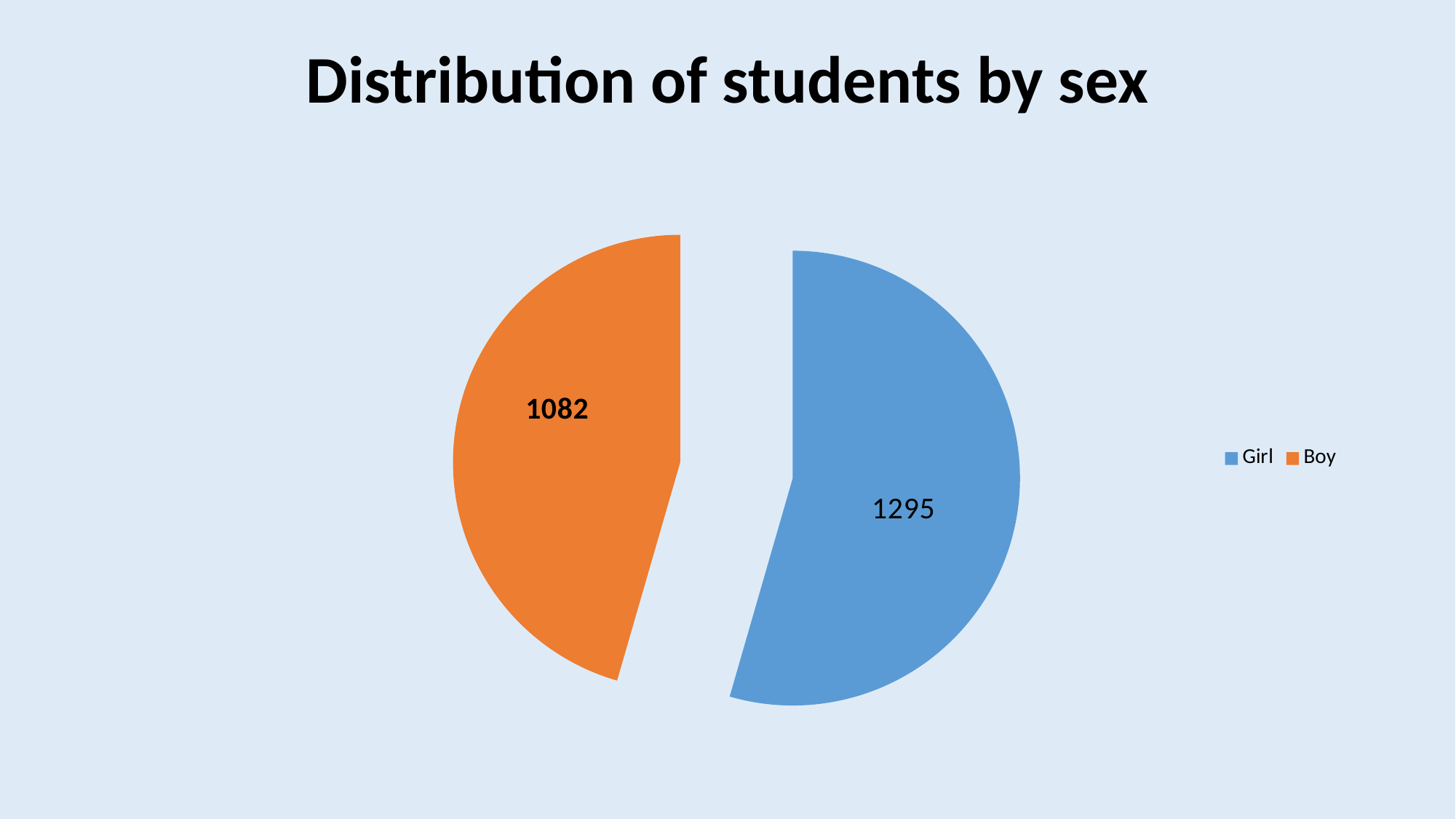
What is the value for Girl in the pie chart? 1295 What is the total of the two slices in the pie chart? 2377 What colour is the Boy slice in the pie chart? Orange What is the difference between the Girl and Boy values? 213 What kind of chart is shown on the slide? Pie chart What is the value for Boy in the pie chart? 1082 How many slices does the pie chart have? 2 Which category has the smallest slice of the pie? Boy How many entries does the legend list? 2 Which category has the largest slice of the pie? Girl What is the title of the chart? Distribution of students by sex Which is larger, the value for Girl or the value for Boy? Girl